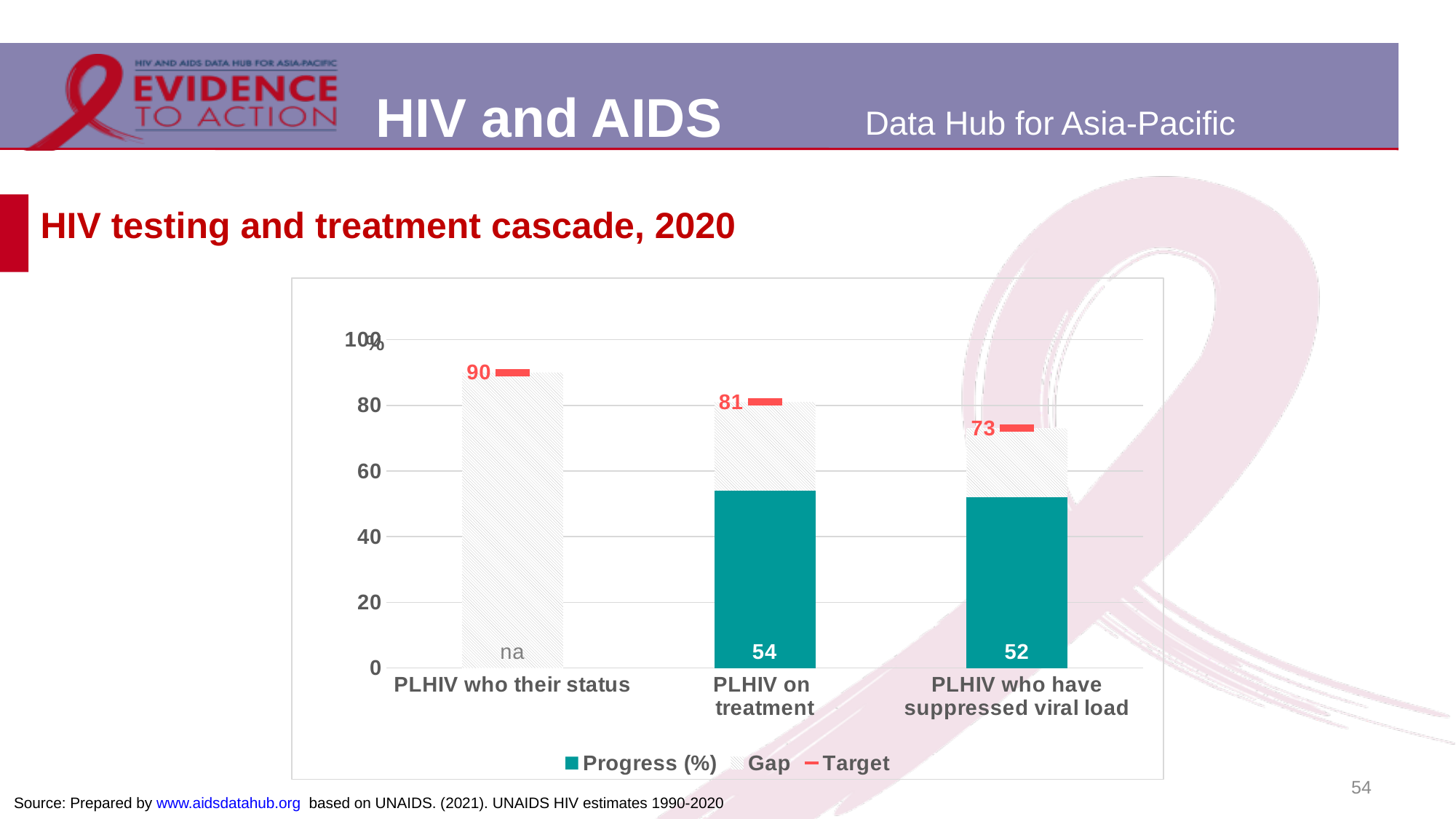
Which category has the highest Target value? PLHIV who their status What is the Progress (%) value for PLHIV on treatment? 54 What is the Target value for PLHIV who know their status? 90 What is the Target value for PLHIV who have suppressed viral load? 73 What is the title of the chart? HIV testing and treatment cascade, 2020 What is the difference between the Target and the Progress (%) value for PLHIV on treatment? 27 How many categories are shown on the x axis? 3 What Progress (%) label is shown for PLHIV who know their status? na What is the Target value for PLHIV on treatment? 81 What is the Progress (%) value for PLHIV who have suppressed viral load? 52 Which category has the lowest Target value? PLHIV who have suppressed viral load How many series does the legend list? 3